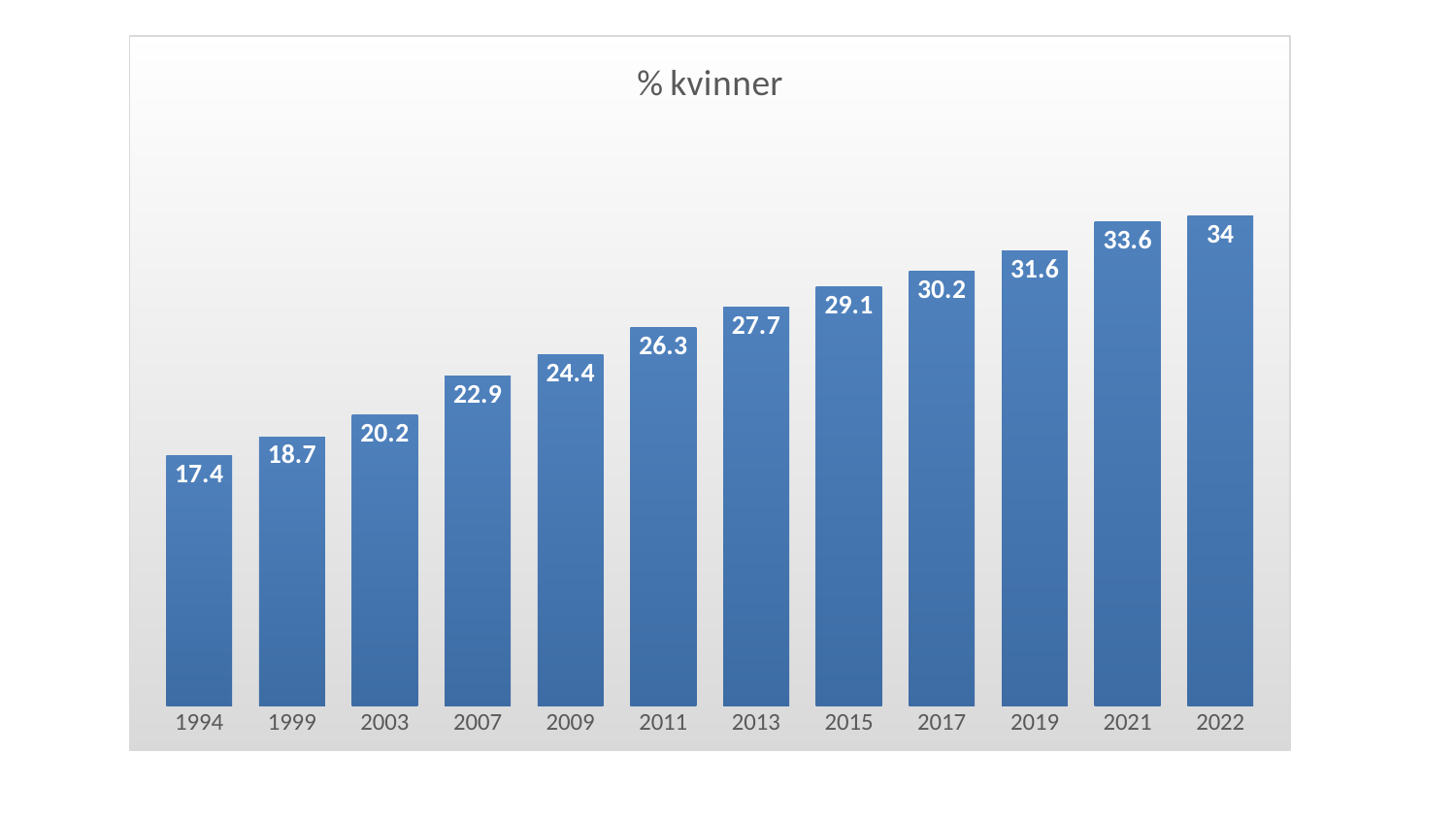
What is the difference between the values for 2022 and 1994? 16.6 How many years are shown on the x axis? 12 What is the title of the chart? % kvinner What kind of chart is this? Bar chart Which is larger, the value for 2009 or the value for 2015? 2015 What is the value for 1994? 17.4 Which year has the highest value? 2022 What is the value for 2013? 27.7 What is the value for 2022? 34 Do the values rise or fall from 1994 to 2022? Rise What is the difference between the values for 2011 and 2007? 3.4 Which year has the lowest value? 1994